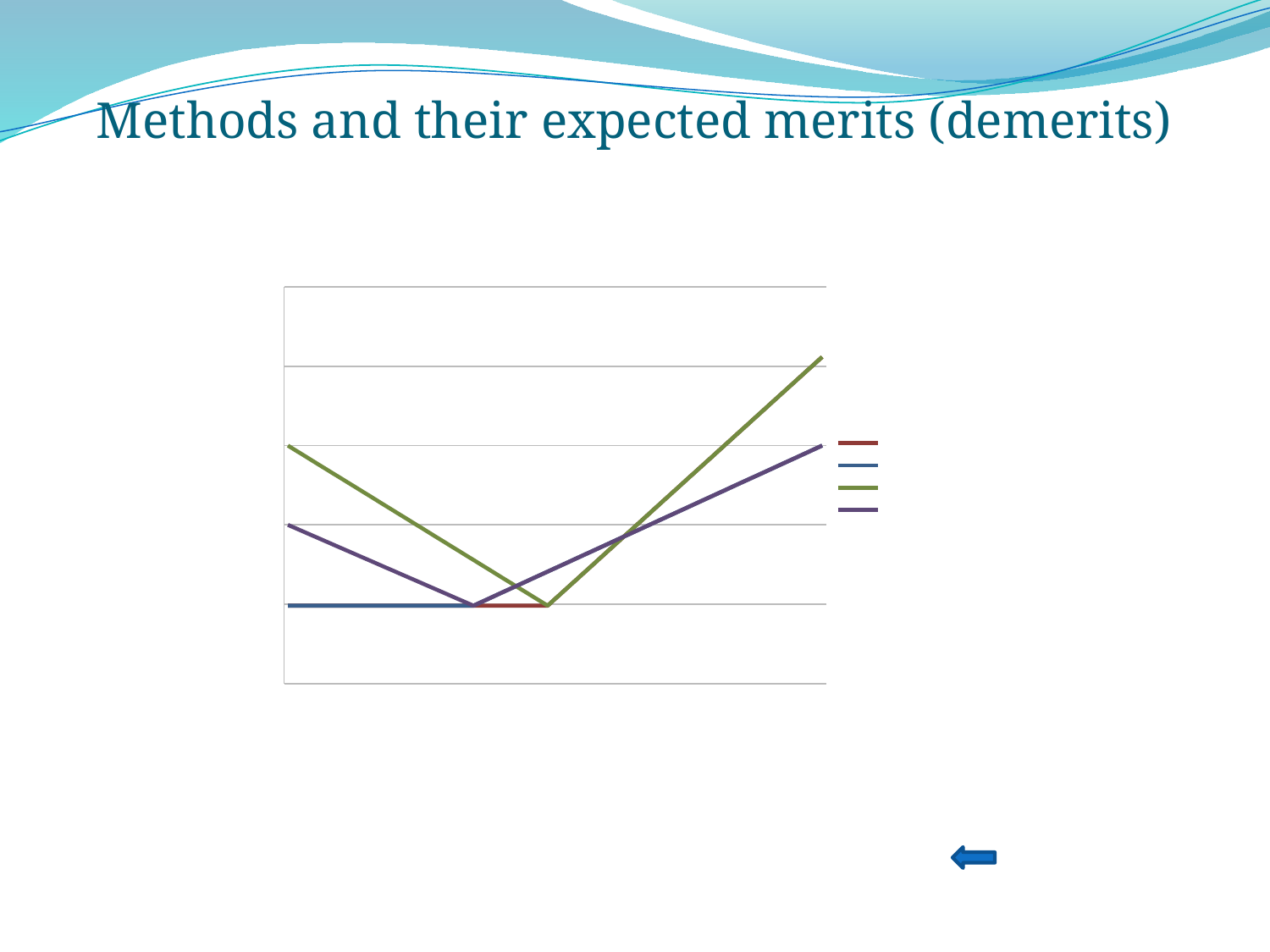
What colours are the four lines in the chart? red, blue, green and purple Does the green line end higher or lower than where it starts? higher What is the title of the slide containing the chart? Methods and their expected merits (demerits) At the right edge of the chart, which line is higher, the green line or the purple line? green line What kind of chart is shown on the slide? line chart At the left edge of the chart, which line is higher, the green line or the purple line? green line How many series does the legend list? 4 Does the purple line end higher or lower than where it starts? higher